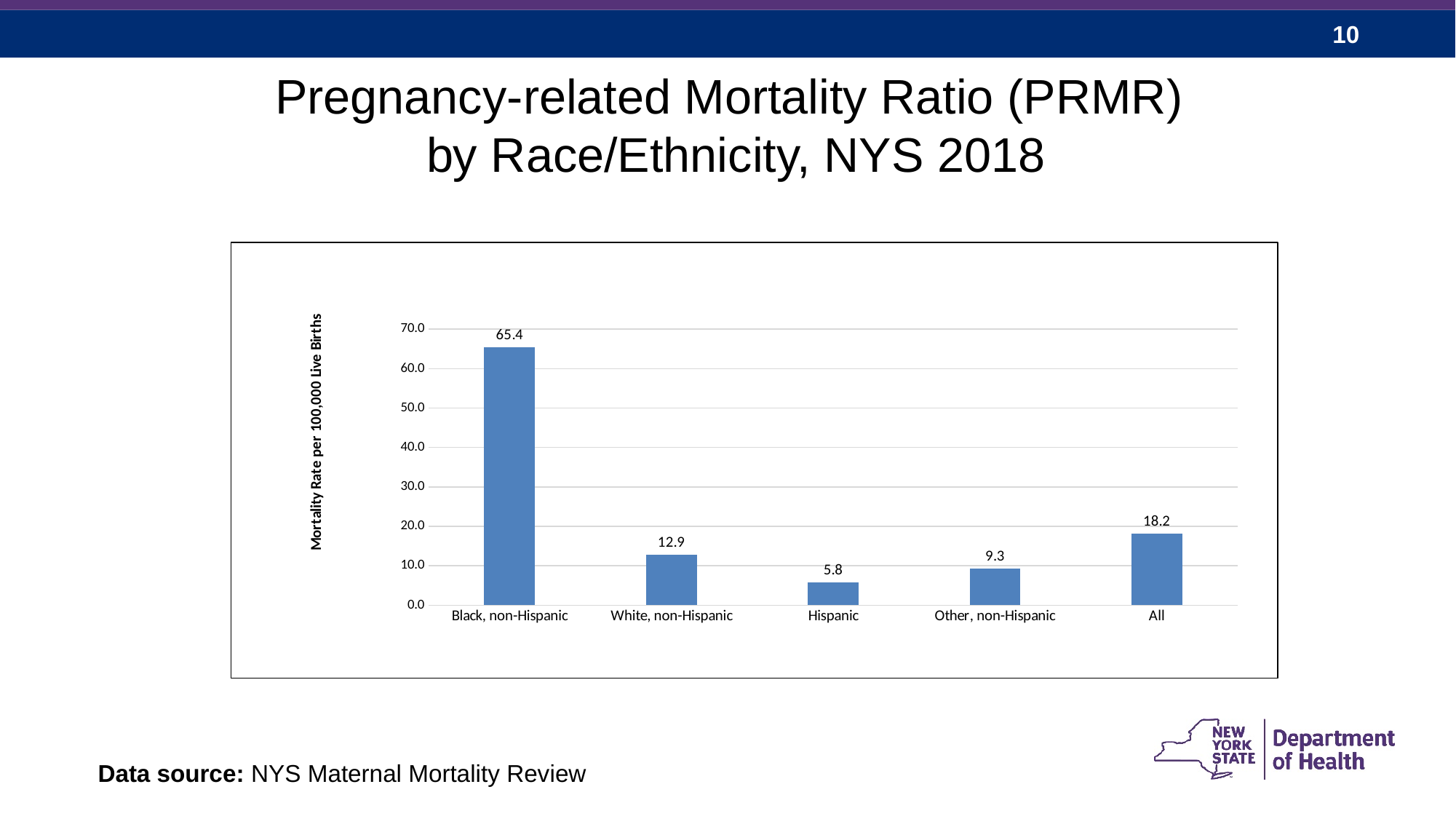
What is the pregnancy-related mortality ratio for All? 18.2 What is the pregnancy-related mortality ratio for Black, non-Hispanic? 65.4 What is the pregnancy-related mortality ratio for Hispanic? 5.8 What is the difference between the mortality ratio for Black, non-Hispanic and White, non-Hispanic? 52.5 How many categories are shown on the x axis of the chart? 5 Which race/ethnicity category has the highest pregnancy-related mortality ratio? Black, non-Hispanic What is the pregnancy-related mortality ratio for White, non-Hispanic? 12.9 Which is larger, the mortality ratio for White, non-Hispanic or for Other, non-Hispanic? White, non-Hispanic Which race/ethnicity category has the lowest pregnancy-related mortality ratio? Hispanic What kind of chart is shown on the slide? Bar chart What is the pregnancy-related mortality ratio for Other, non-Hispanic? 9.3 Is the value for Black, non-Hispanic greater or less than 60.0? greater